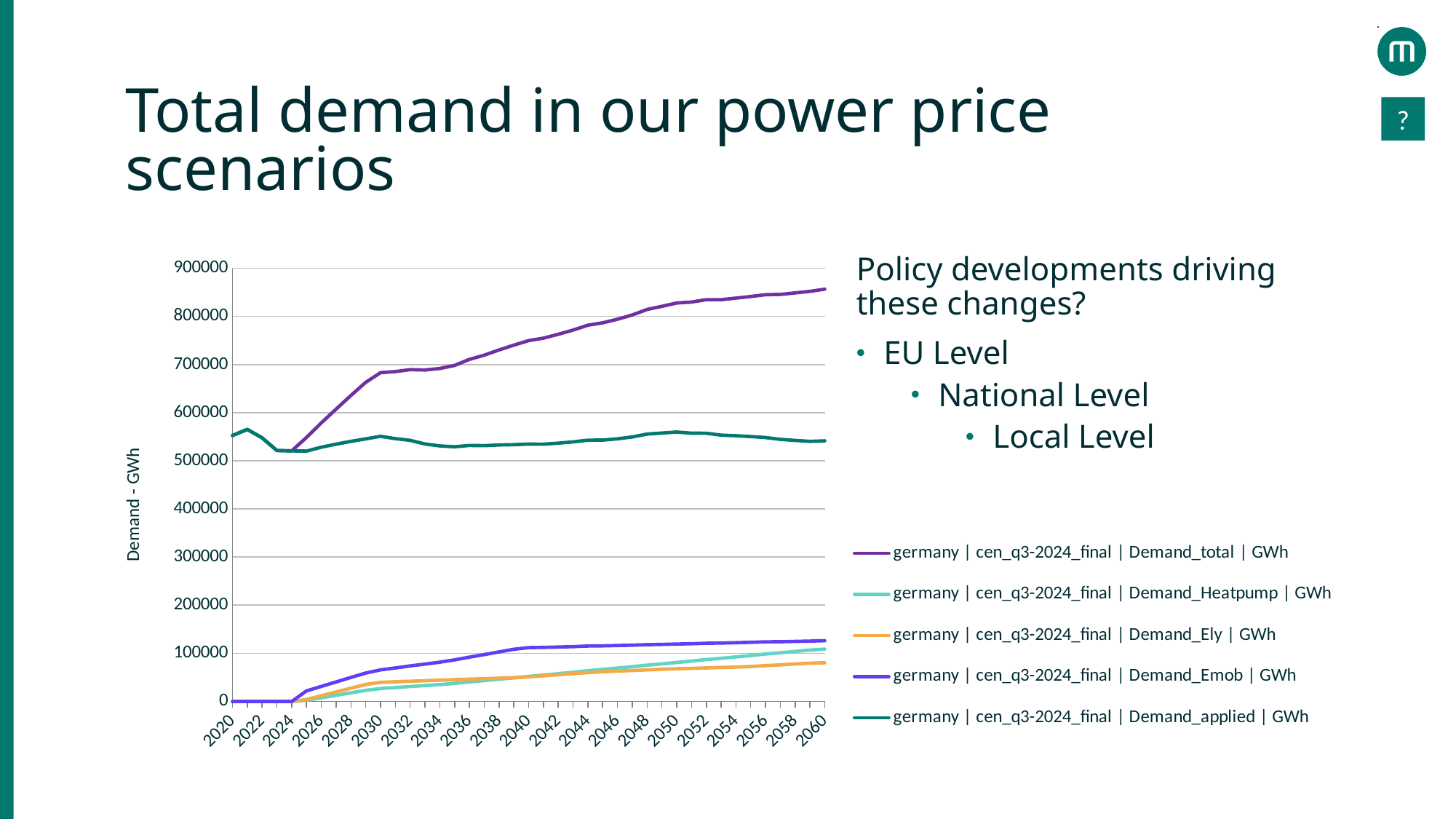
Is the value for Demand_applied in 2020 greater or less than 500000? greater Is the value for Demand_total in 2040 greater or less than 700000? greater Is the value for Demand_total in 2060 greater or less than 800000? greater In 2050, which is larger: Demand_Emob or Demand_Ely? Demand_Emob Which series has the lowest value in 2060? Demand_Ely Which series has the highest value in 2060? Demand_total How many series does the legend list? 5 Does the Demand_total series rise or fall between 2024 and 2060? rise What kind of chart is shown on the slide? line chart What is the label on the vertical axis? Demand - GWh Which series is plotted with the purple line at the top of the chart? germany | cen_q3-2024_final | Demand_total | GWh